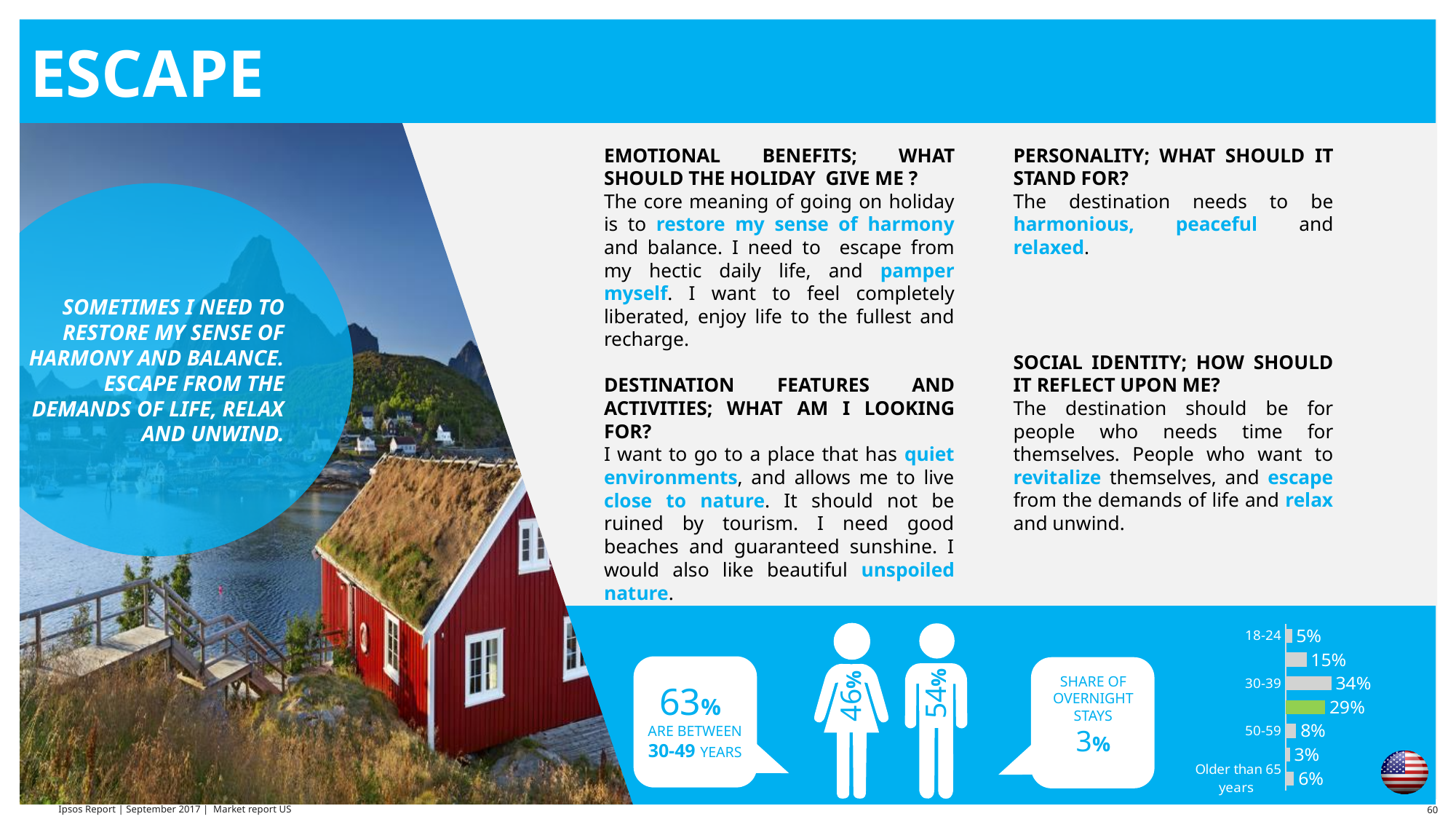
In the age bar chart at the bottom right, what is the difference between the values for 30-39 and 50-59? 26% How many bars are plotted in the age bar chart at the bottom right? 7 In the age bar chart at the bottom right, what is the value for the 'Older than 65 years' group? 6% In the age bar chart at the bottom right, which bar is coloured green rather than grey? The 29% bar In the age bar chart at the bottom right, which is larger: the value for 18-24 or the value for 'Older than 65 years'? Older than 65 years In the age bar chart at the bottom right, what is the value for the 50-59 age group? 8% In the age bar chart at the bottom right, what is the value for the 30-39 age group? 34% In the age bar chart at the bottom right, which labelled age group has the highest value? 30-39 In the age bar chart at the bottom right, what is the lowest value shown on any bar? 3% In the age bar chart at the bottom right, what is the value for the 18-24 age group? 5% What kind of chart is the age chart at the bottom right of the slide? Bar chart In the age bar chart at the bottom right, what is the highest value shown on any bar? 34%